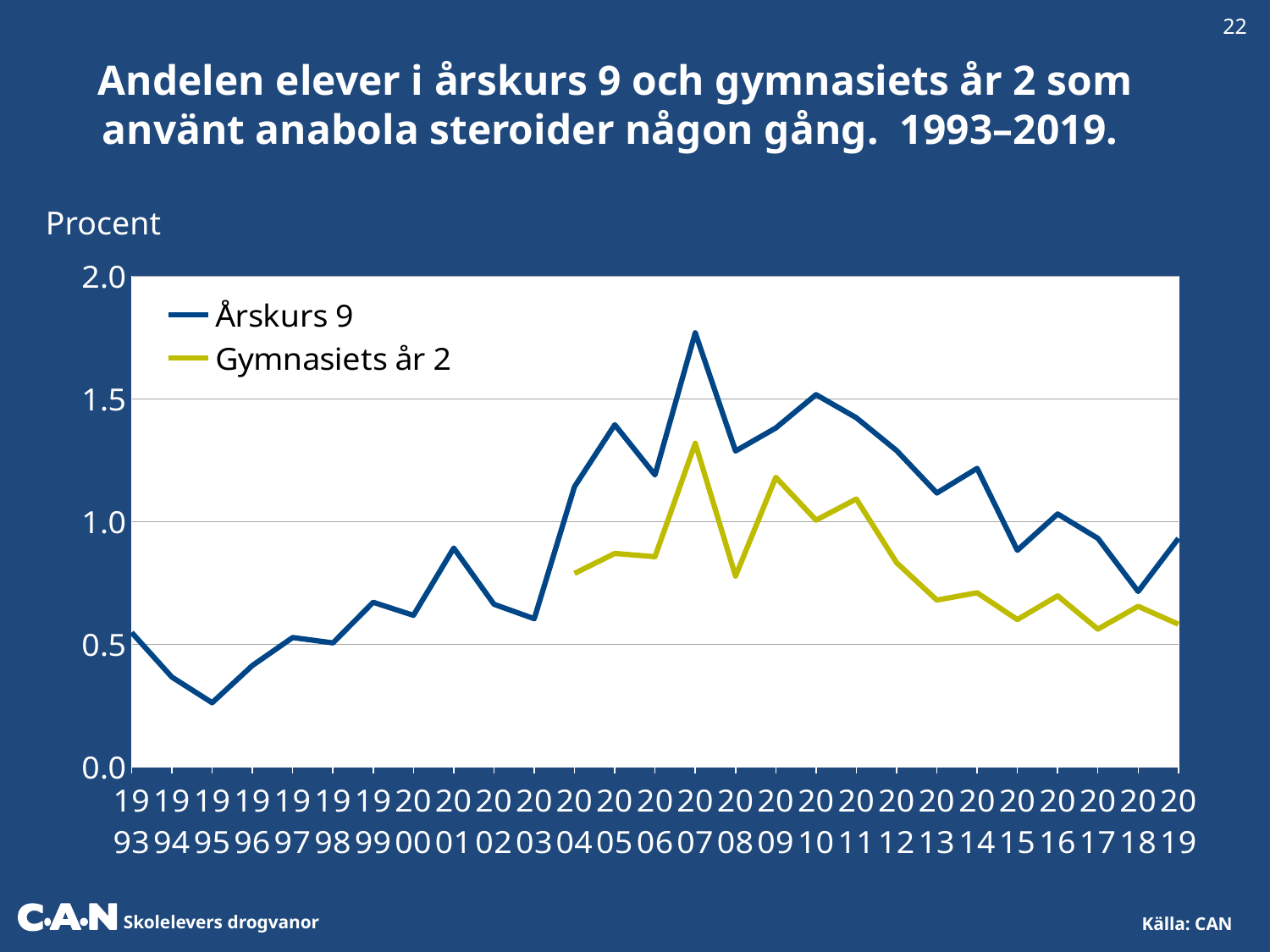
In which year does the Årskurs 9 line reach its highest value? 2007 Is the value for Årskurs 9 in 1995 greater or less than 0.5? less In which year does the Gymnasiets år 2 line reach its highest value? 2007 How many series does the legend list? 2 What label is shown above the y axis of the chart? Procent In which year does the Årskurs 9 line reach its lowest value? 1995 Is the value for Årskurs 9 in 2007 greater or less than 1.5? greater Do the values for Årskurs 9 rise or fall from 2010 to 2015? Fall What kind of chart is shown on the slide? Line chart Is the value for Gymnasiets år 2 in 2019 greater or less than 1.0? less How many years are shown on the x axis? 27 Which series has the higher value in 2007, Årskurs 9 or Gymnasiets år 2? Årskurs 9